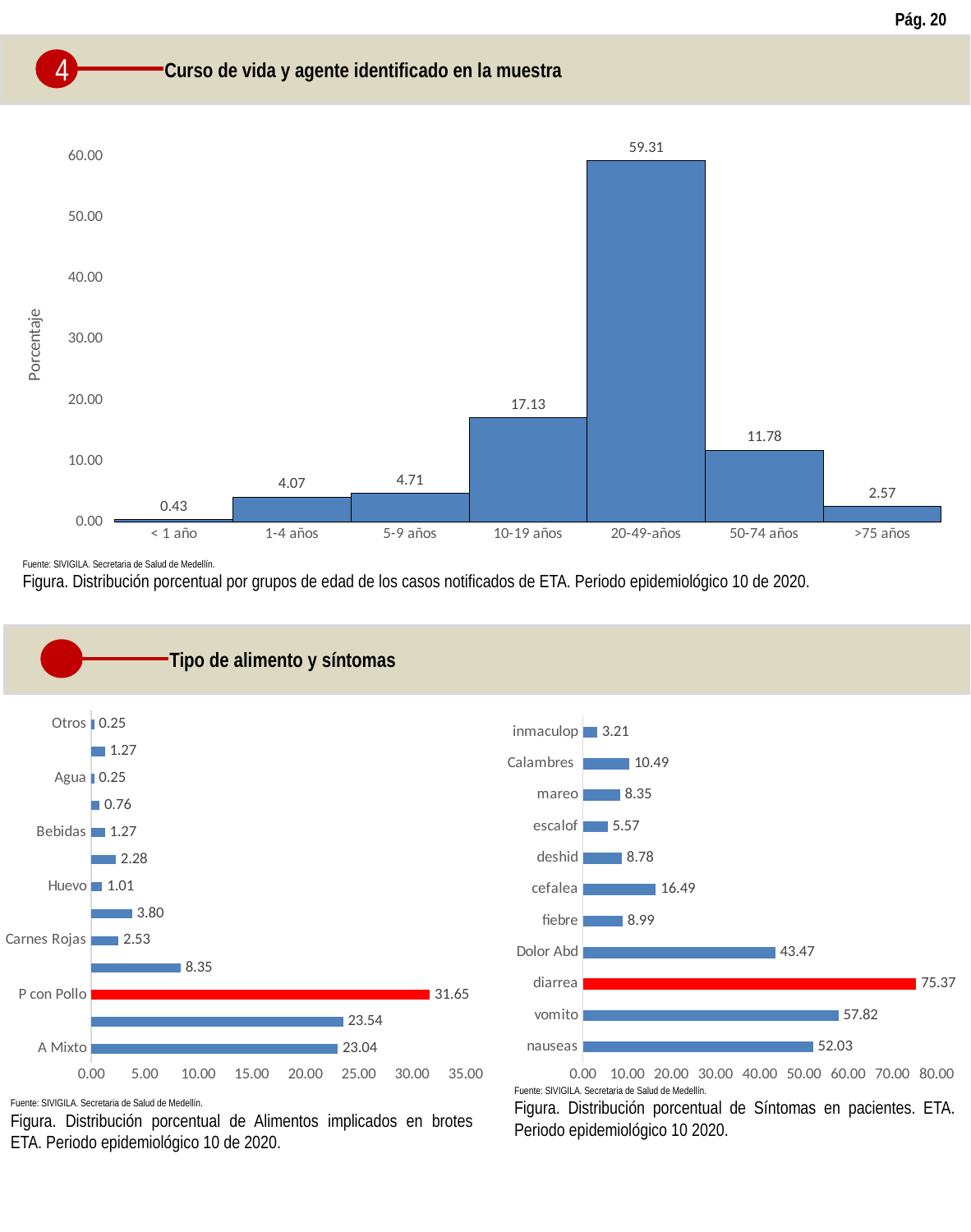
In the top chart (age groups), which age group has the lowest percentage? < 1 año In the top chart (age groups), how many age groups are shown on the x axis? 7 In the top chart (age groups), what is the difference between the values for 10-19 años and 50-74 años? 5.35 In the bottom-right chart (Síntomas), what is the value for Dolor Abd? 43.47 In the bottom-left chart (Alimentos), which labelled category has the highest value? P con Pollo What kind of chart is the top chart (age groups)? bar chart In the top chart (age groups), which is larger, the value for 1-4 años or 5-9 años? 5-9 años In the bottom-left chart (Alimentos), what colour is the bar for P con Pollo? red In the top chart (age groups), what is the value for 20-49-años? 59.31 In the bottom-right chart (Síntomas), what is the difference between the values for vomito and nauseas? 5.79 In the bottom-right chart (Síntomas), which symptom has the highest value? diarrea In the bottom-left chart (Alimentos), what is the value for P con Pollo? 31.65